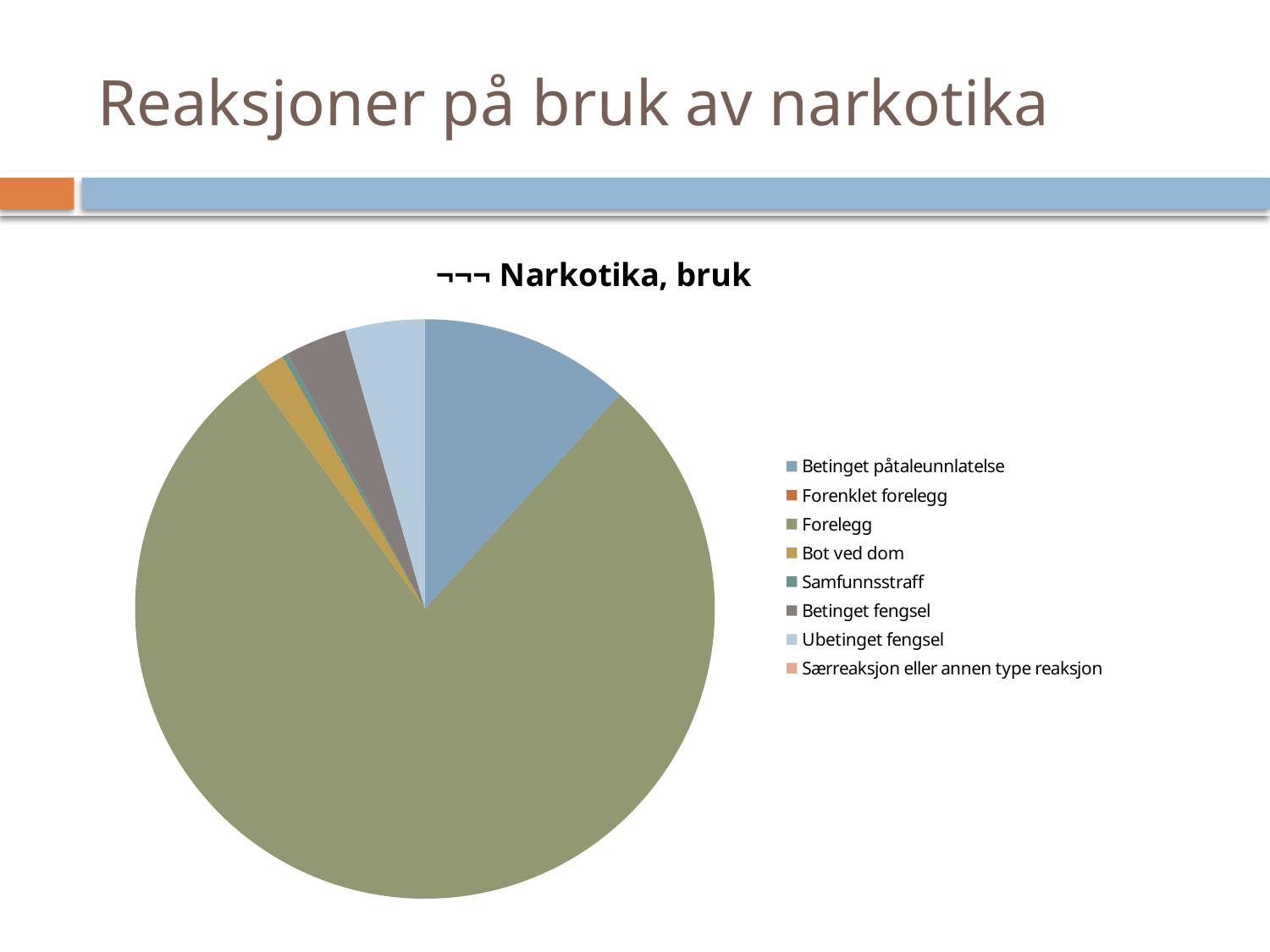
Which is larger, the slice for Forelegg or the slice for Betinget påtaleunnlatelse? Forelegg Does the Forelegg slice take up more or less than half of the pie? more What kind of chart is shown on the slide? pie chart Which category has the largest slice of the pie? Forelegg Which is larger, the slice for Betinget fengsel or the slice for Samfunnsstraff? Betinget fengsel What is the title of the chart? ¬¬¬ Narkotika, bruk Which legend entry is shown in the olive green colour that fills the largest slice? Forelegg How many entries does the chart legend list? 8